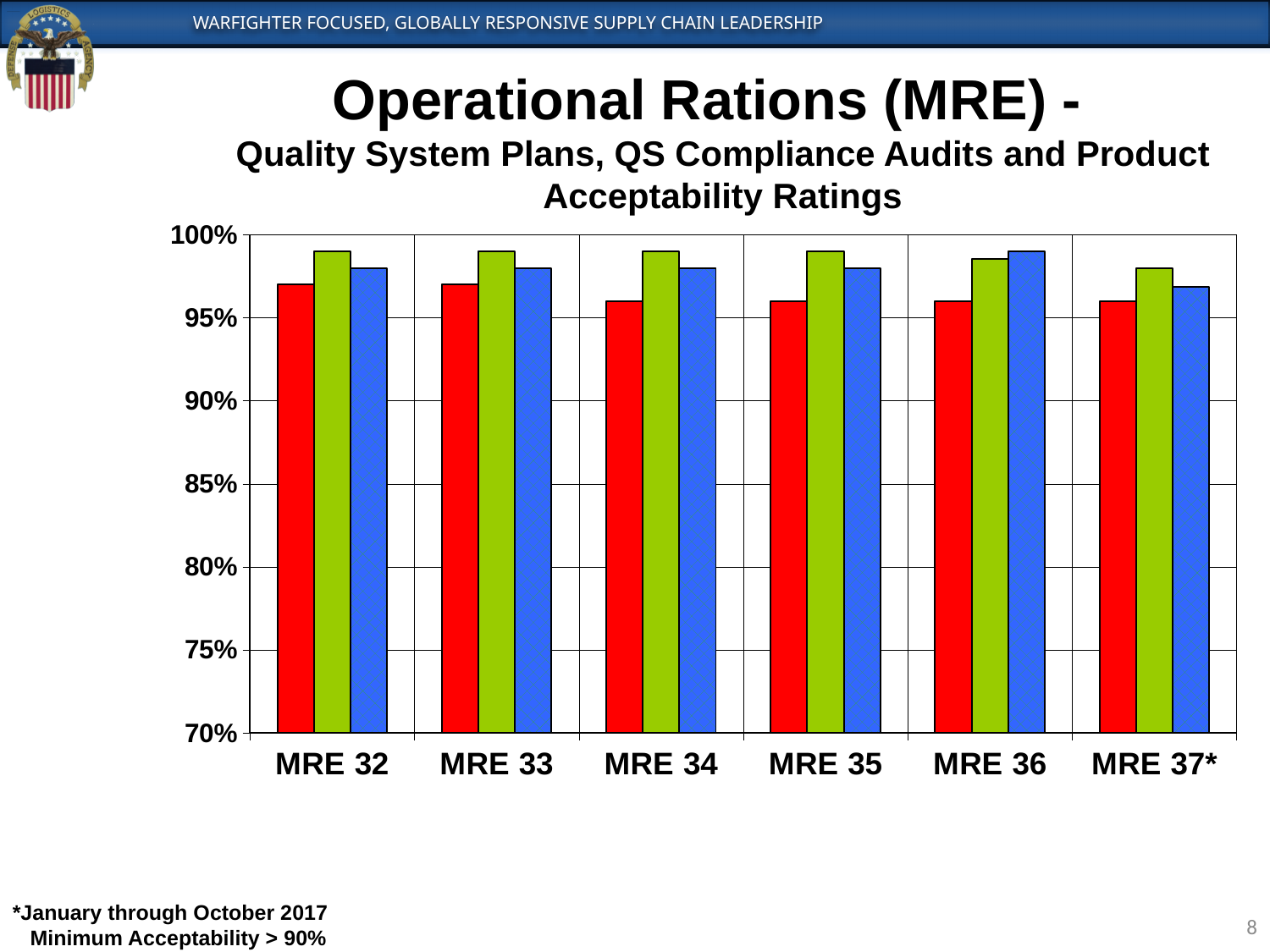
What kind of chart is shown on the slide? Bar chart For MRE 32, which is larger, the red bar or the green bar? The green bar Is the red bar for MRE 32 greater or less than 95%? greater Is the blue bar for MRE 37* greater or less than 90%? greater How many bars are plotted for each MRE category? 3 What is the main title of the slide's chart? Operational Rations (MRE) - Quality System Plans, QS Compliance Audits and Product Acceptability Ratings Which MRE category has the lowest blue bar? MRE 37* How many MRE categories are shown on the x axis? 6 What is the lowest value shown on the y axis? 70% Is the green bar for MRE 34 greater or less than 95%? greater For MRE 35, which is larger, the red bar or the blue bar? The blue bar